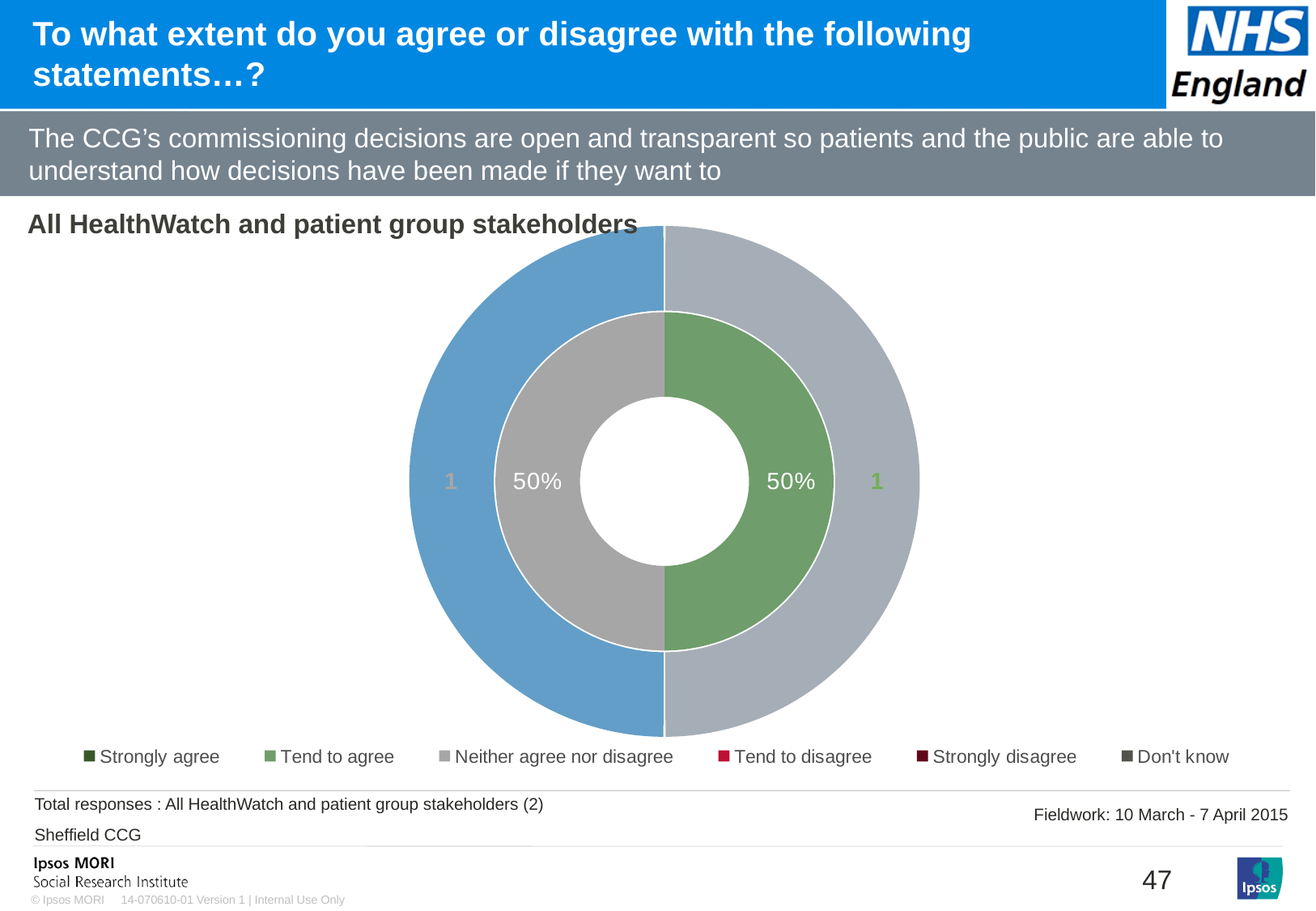
What is the combined percentage of 'Tend to agree' and 'Neither agree nor disagree'? 100% How many respondents are shown in the outer ring for the green 'Tend to agree' segment? 1 How many segments with printed values appear in the inner ring of the chart? 2 What kind of chart is shown on the slide? Doughnut chart How many response categories does the legend list? 6 How many respondents are shown in the outer ring for the grey 'Neither agree nor disagree' segment? 1 What percentage of All HealthWatch and patient group stakeholders said 'Tend to agree'? 50% What is the difference between the 'Tend to agree' and 'Neither agree nor disagree' percentages? 0 What percentage of All HealthWatch and patient group stakeholders said 'Neither agree nor disagree'? 50% What is the subtitle above the chart describing the respondent group? All HealthWatch and patient group stakeholders What is the total number of responses stated for All HealthWatch and patient group stakeholders? 2